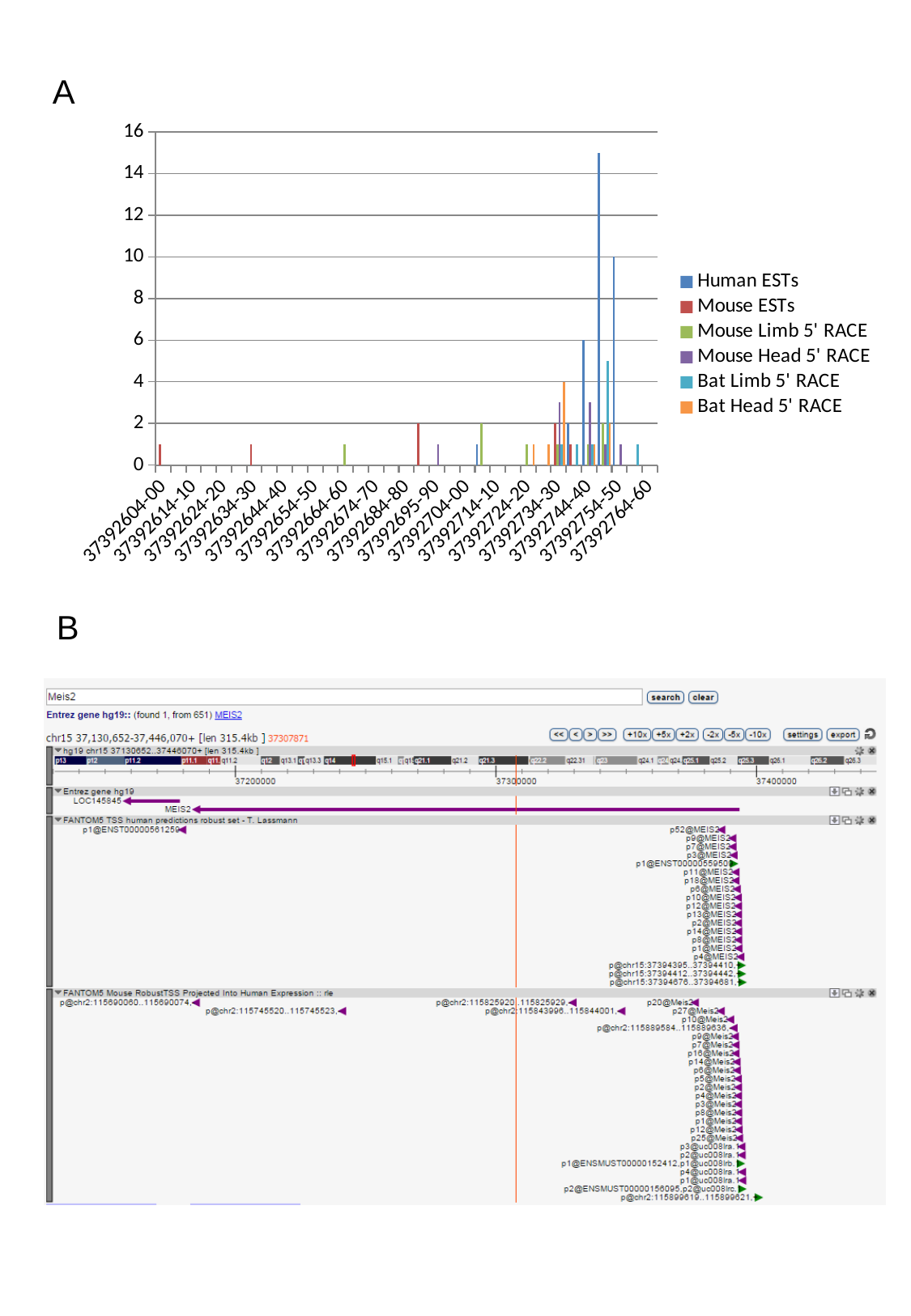
What is the highest value shown on the y axis of chart A? 16 In chart A, is the tallest Human ESTs bar greater or less than 14? greater What is the first category label on the x axis of chart A? 37392604-00 How many series does the legend of chart A list? 6 In chart A, which series is shown in red in the legend? Mouse ESTs In chart A, is the tallest Human ESTs bar greater or less than the tallest Mouse ESTs bar? greater In chart A, is the Mouse ESTs bar near 37392684-80 greater or less than 4? less In chart A, is the tallest Bat Head 5' RACE bar greater or less than 6? less In chart A, which series has the tallest bar? Human ESTs What kind of chart is chart A? bar chart